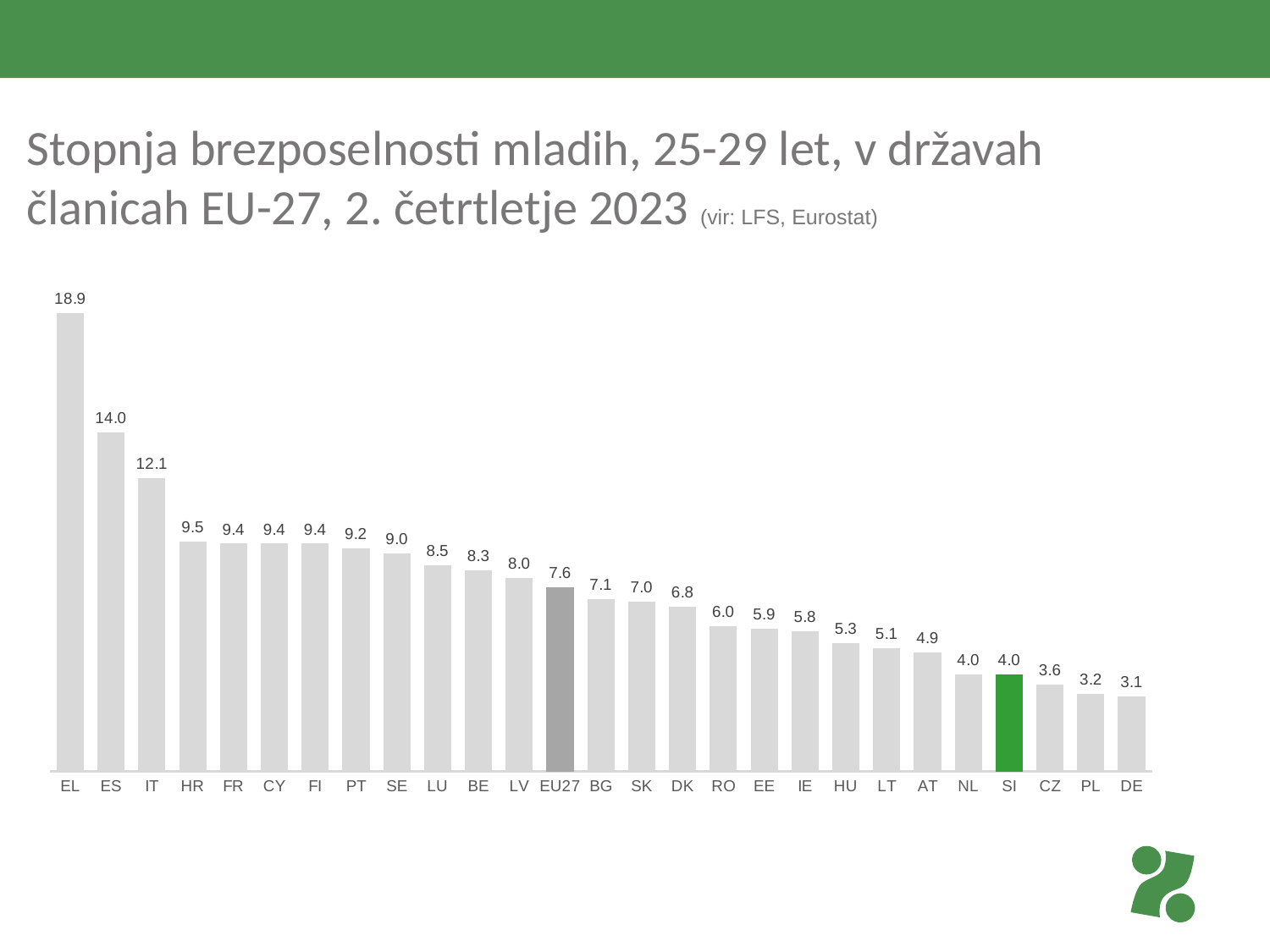
Which country has the highest value? EL What kind of chart is this? bar chart What is the value for SI? 4.0 How many categories are shown on the x axis? 27 Which country has the lowest value? DE Which bar is coloured green? SI Do the values rise or fall from left to right along the x axis? fall What is the value for HR? 9.5 What is the value for EU27? 7.6 Which is larger, the value for IT or the value for HR? IT What is the difference between the values for EU27 and SI? 3.6 What is the difference between the values for EL and ES? 4.9